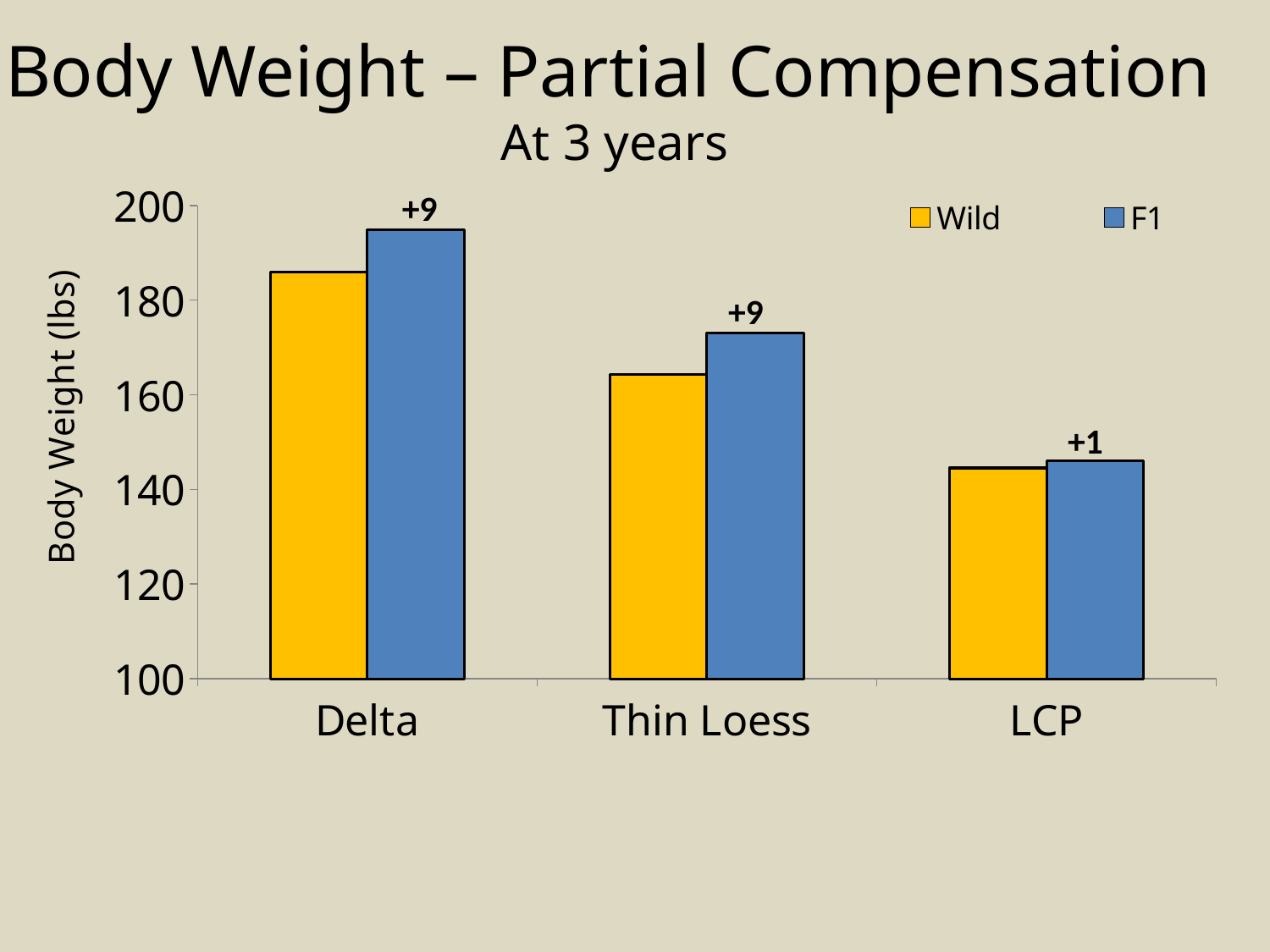
How many categories are shown on the x axis? 3 What difference is printed above the F1 bar for LCP? +1 Is the Wild value for Delta greater or less than 180? greater Which series are listed in the legend? Wild and F1 How many series does the legend list? 2 Which category has the lowest Wild body weight? LCP What is the label on the y axis? Body Weight (lbs) Which category has the highest F1 body weight? Delta Do the F1 body weights rise or fall from Delta to LCP along the x axis? fall What kind of chart is shown on the slide? bar chart What difference is printed above the F1 bar for Delta? +9 Which is larger: the Wild value for Delta or the F1 value for Thin Loess? Wild value for Delta